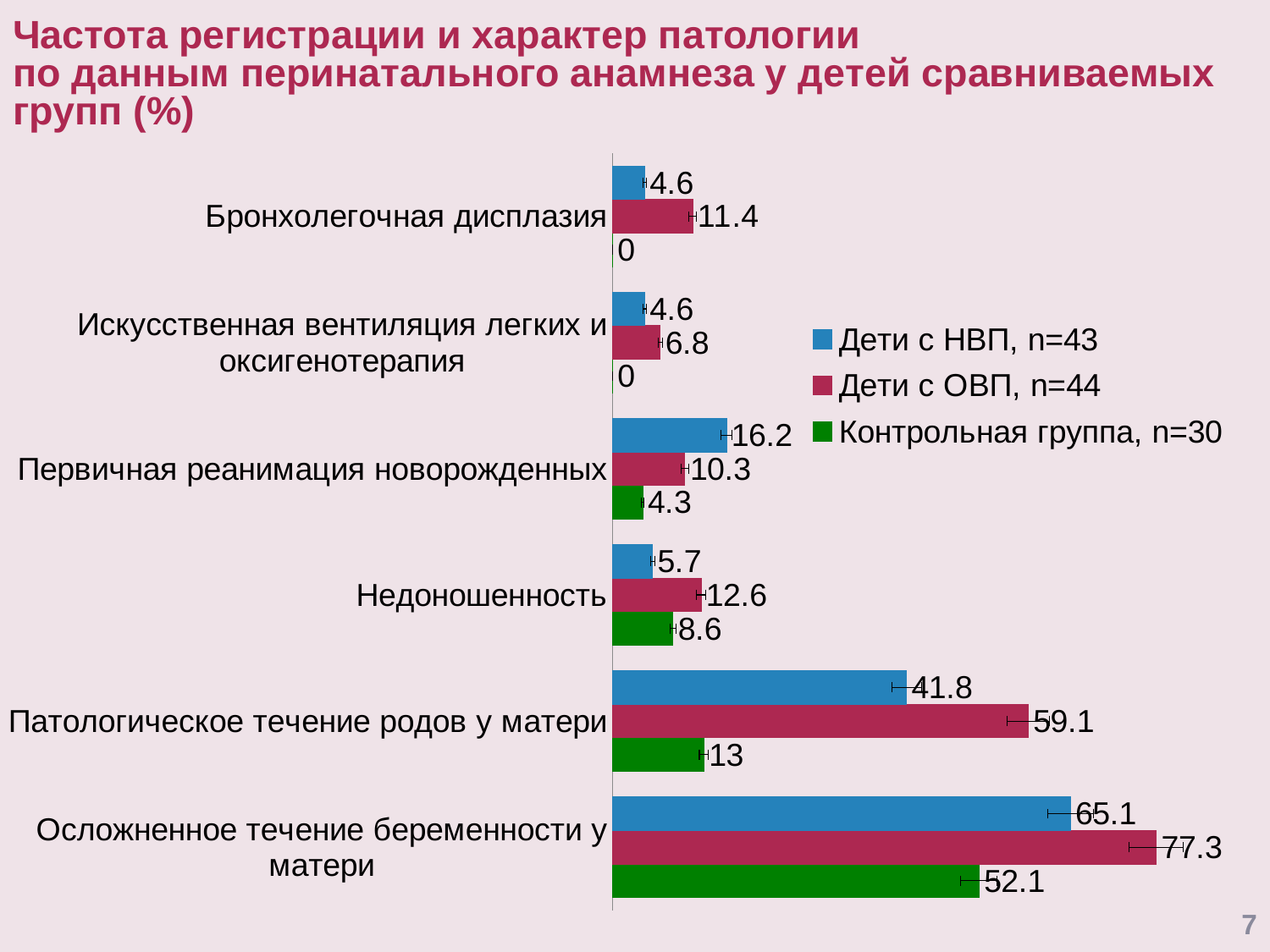
What kind of chart is shown on the slide? Bar chart What is the value for 'Дети с ОВП, n=44' in the 'Недоношенность' category? 12.6 How many series does the legend list? 3 Which is larger in the 'Первичная реанимация новорожденных' category: 'Дети с НВП, n=43' or 'Дети с ОВП, n=44'? Дети с НВП, n=43 Which series has the lowest value in the 'Осложненное течение беременности у матери' category? Контрольная группа, n=30 How many categories are shown on the chart? 6 What is the value for 'Дети с НВП, n=43' in the 'Первичная реанимация новорожденных' category? 16.2 What is the difference between 'Дети с ОВП, n=44' and 'Дети с НВП, n=43' in the 'Патологическое течение родов у матери' category? 17.3 What is the value for 'Контрольная группа, n=30' in the 'Патологическое течение родов у матери' category? 13 Which category has the highest value for 'Дети с ОВП, n=44'? Осложненное течение беременности у матери What colour represents 'Контрольная группа, n=30' in the chart? Green What is the value for 'Контрольная группа, n=30' in the 'Бронхолегочная дисплазия' category? 0